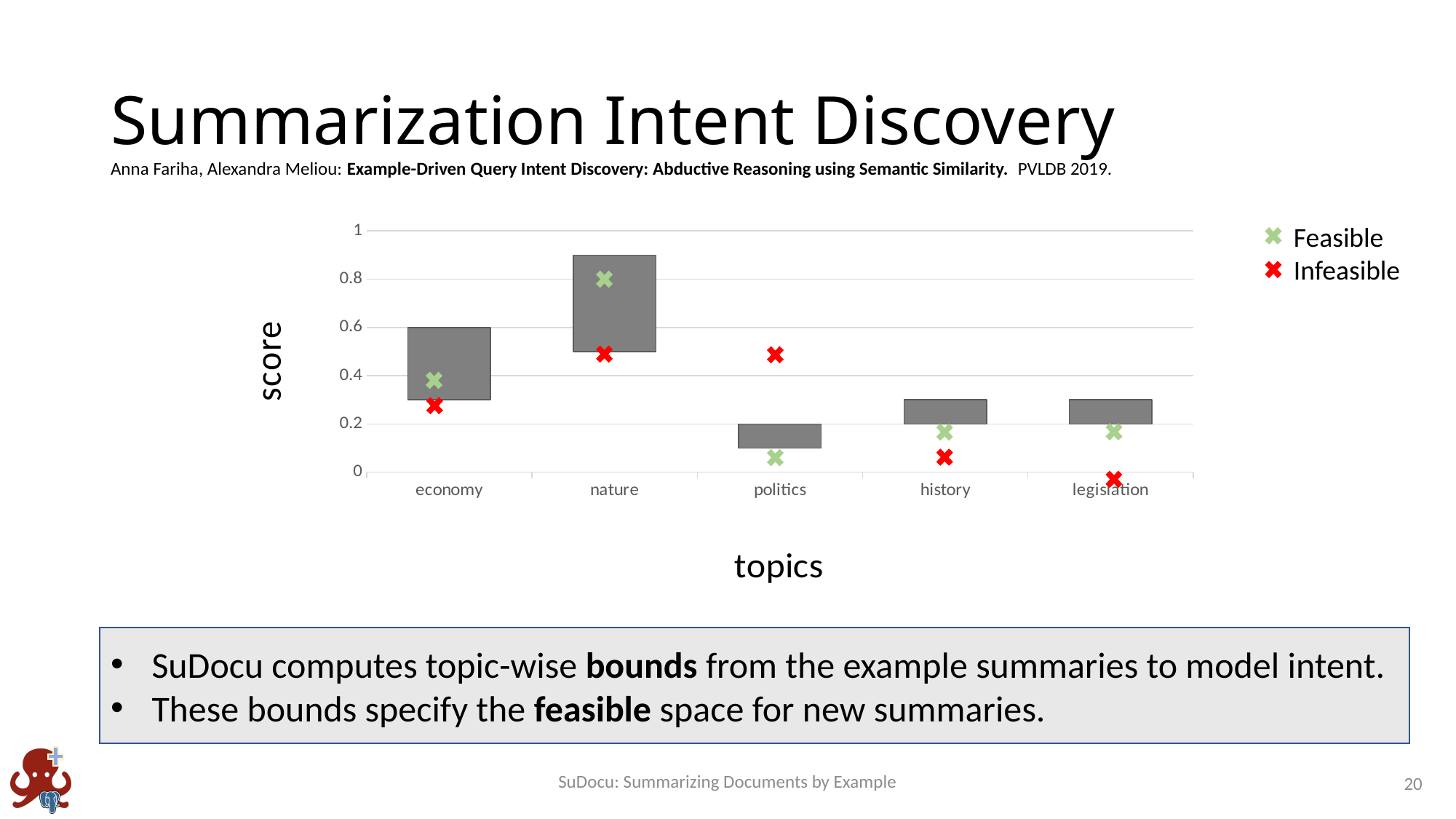
Is the Infeasible marker for politics greater or less than 0.4? greater What is the label of the y axis of the chart? score Is the Feasible marker for politics greater or less than 0.2? less What is the lower bound of the bar for history? 0.2 What is the upper bound of the bar for politics? 0.2 Which topic has the bar with the lowest score range? politics What are the two legend entries in the chart? Feasible, Infeasible Which topic has the bar reaching the highest score? nature How many entries does the chart's legend list? 2 What is the upper bound of the bar for economy? 0.6 Is the Feasible marker for nature greater or less than 0.6? greater How many topics are shown on the x axis of the chart? 5